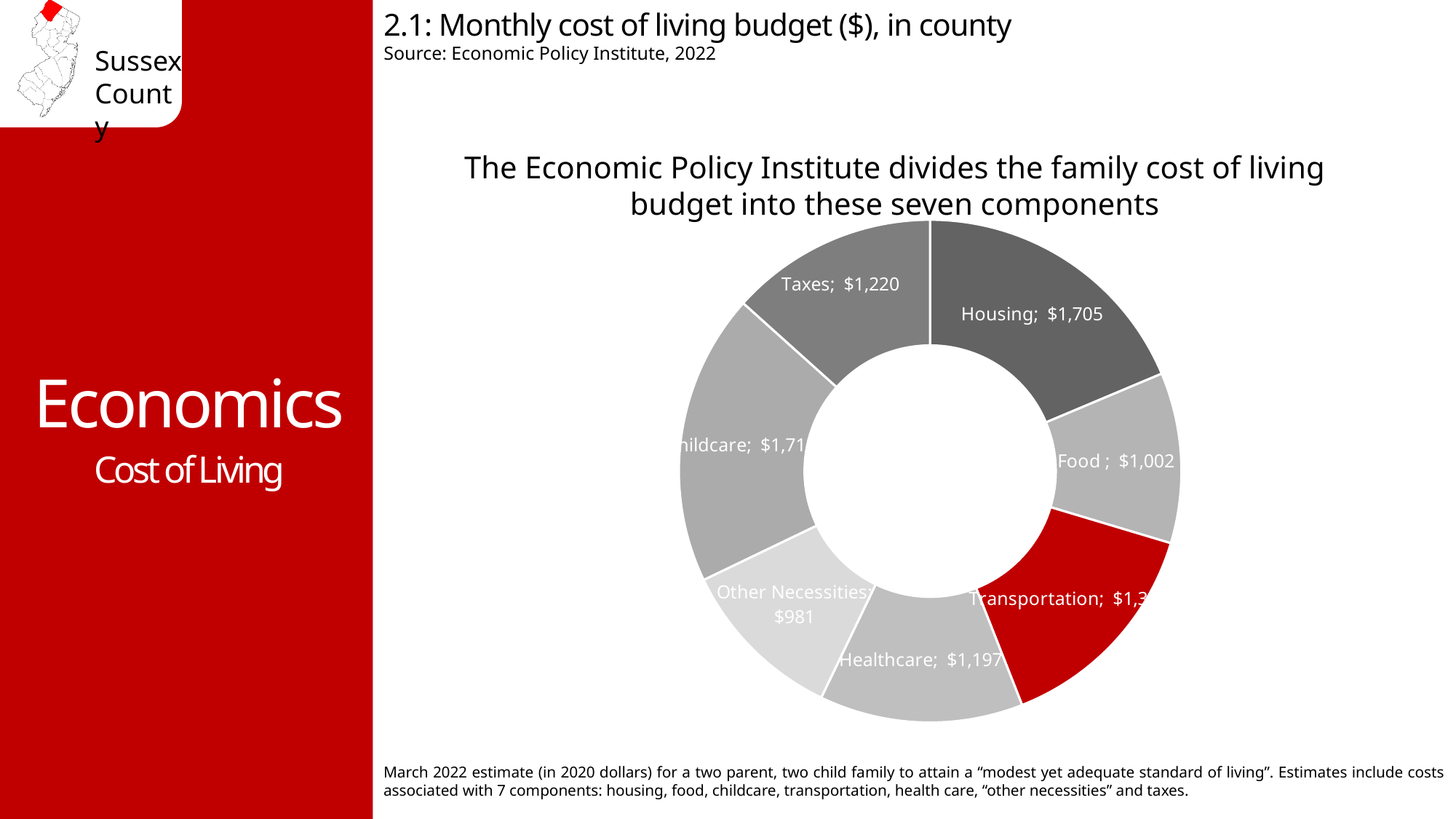
What type of chart is shown on the slide? Doughnut (pie) chart Which component is shown in red on the chart? Transportation What is the difference between the Housing and Taxes monthly costs? $485 What is the monthly cost for Other Necessities? $981 How many components does the chart divide the cost of living budget into? 7 What is the monthly cost for Healthcare? $1,197 What is the monthly cost for Taxes? $1,220 What is the difference between the Healthcare and Other Necessities monthly costs? $216 Which is larger, the monthly cost for Healthcare or for Food? Healthcare What is the monthly cost for Food? $1,002 What is the monthly cost for Housing? $1,705 Which component has the lowest monthly cost? Other Necessities